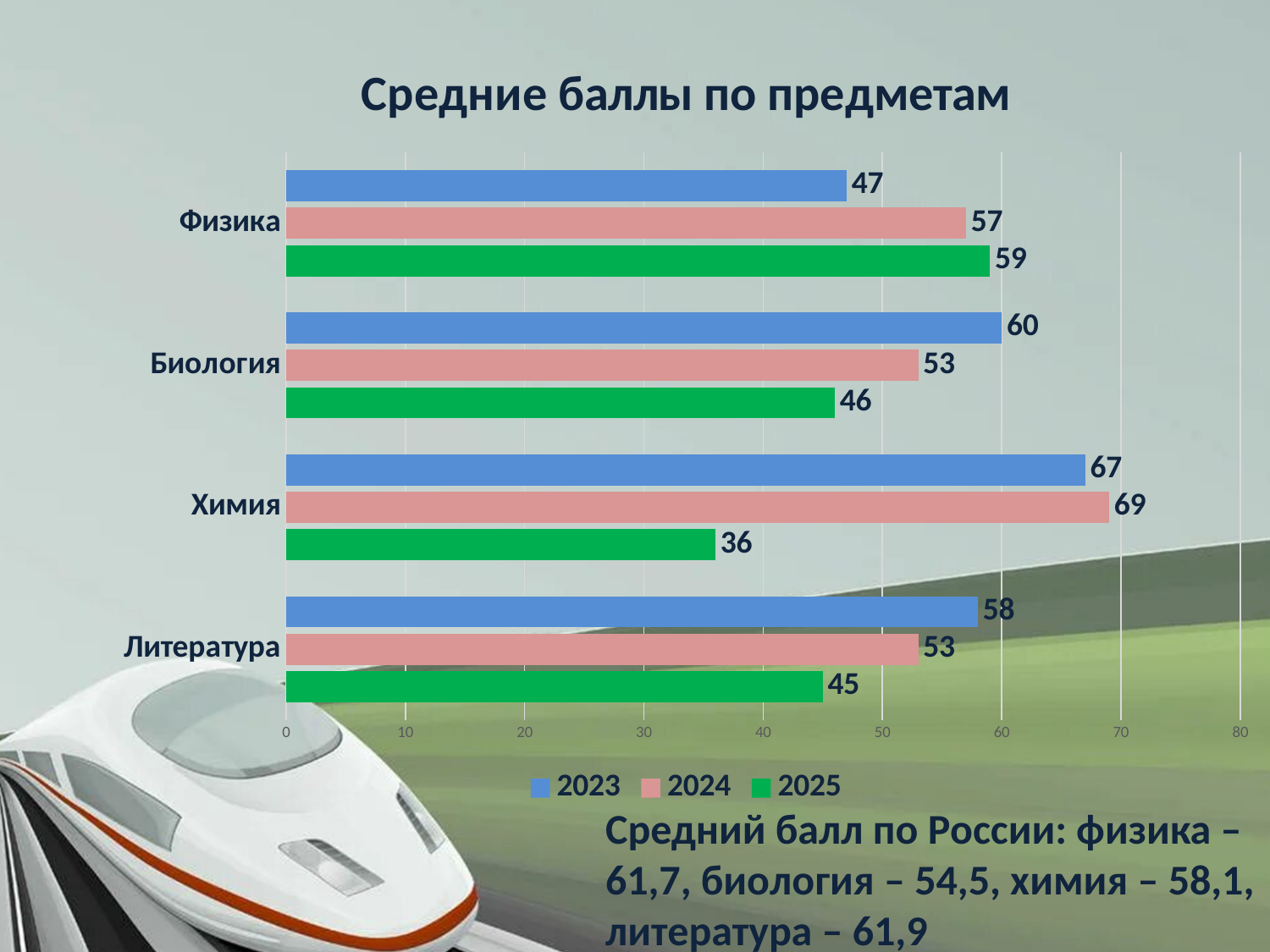
What is the value for Физика in 2023? 47 What is the title of the chart? Средние баллы по предметам Which subject has the highest value in the 2024 series? Химия How many series does the legend list? 3 What is the difference between the 2024 and 2025 values for Химия? 33 How many subjects are shown on the chart? 4 What kind of chart is shown on the slide? bar chart Is the 2023 value for Химия greater or less than 60? greater Which is larger for Биология: the 2023 value or the 2025 value? 2023 What is the value for Химия in 2025? 36 Which subject has the lowest value in the 2025 series? Химия What is the value for Литература in 2024? 53